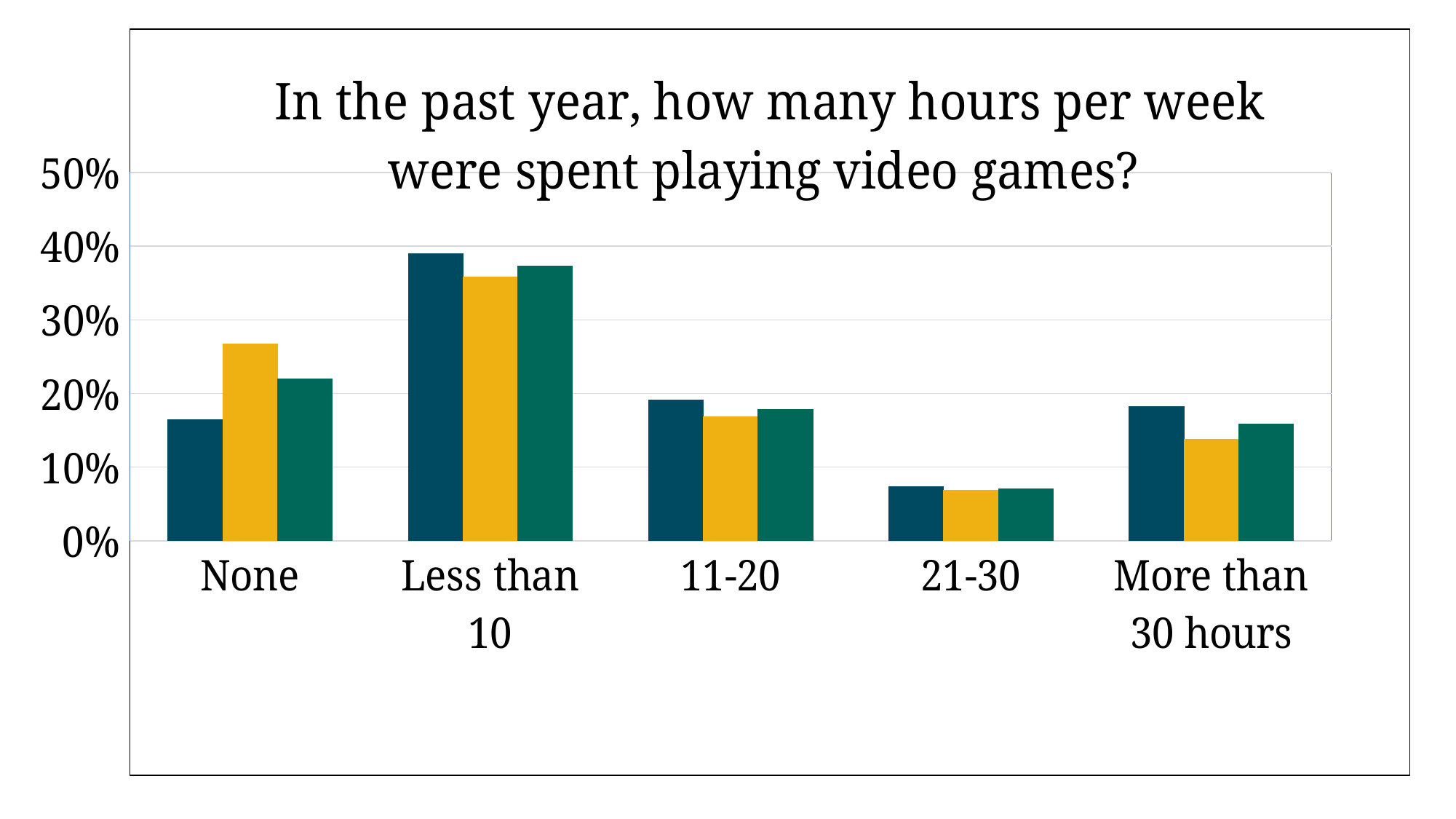
Which category has the lowest bars in the chart? 21-30 How many categories are shown on the x axis of the chart? 5 What is the title of the chart? In the past year, how many hours per week were spent playing video games? How many bars are shown for each category in the chart? 3 For the "None" category, which bar is taller: the dark blue bar or the yellow bar? the yellow bar Is the value of the yellow bar for "None" greater or less than 20%? greater Is the value of the green bar for "More than 30 hours" greater or less than 20%? less Is the value of the dark blue bar for "Less than 10" greater or less than 30%? greater Which category has the highest bars in the chart? Less than 10 For the "More than 30 hours" category, which bar is taller: the dark blue bar or the yellow bar? the dark blue bar What kind of chart is shown on the slide? bar chart